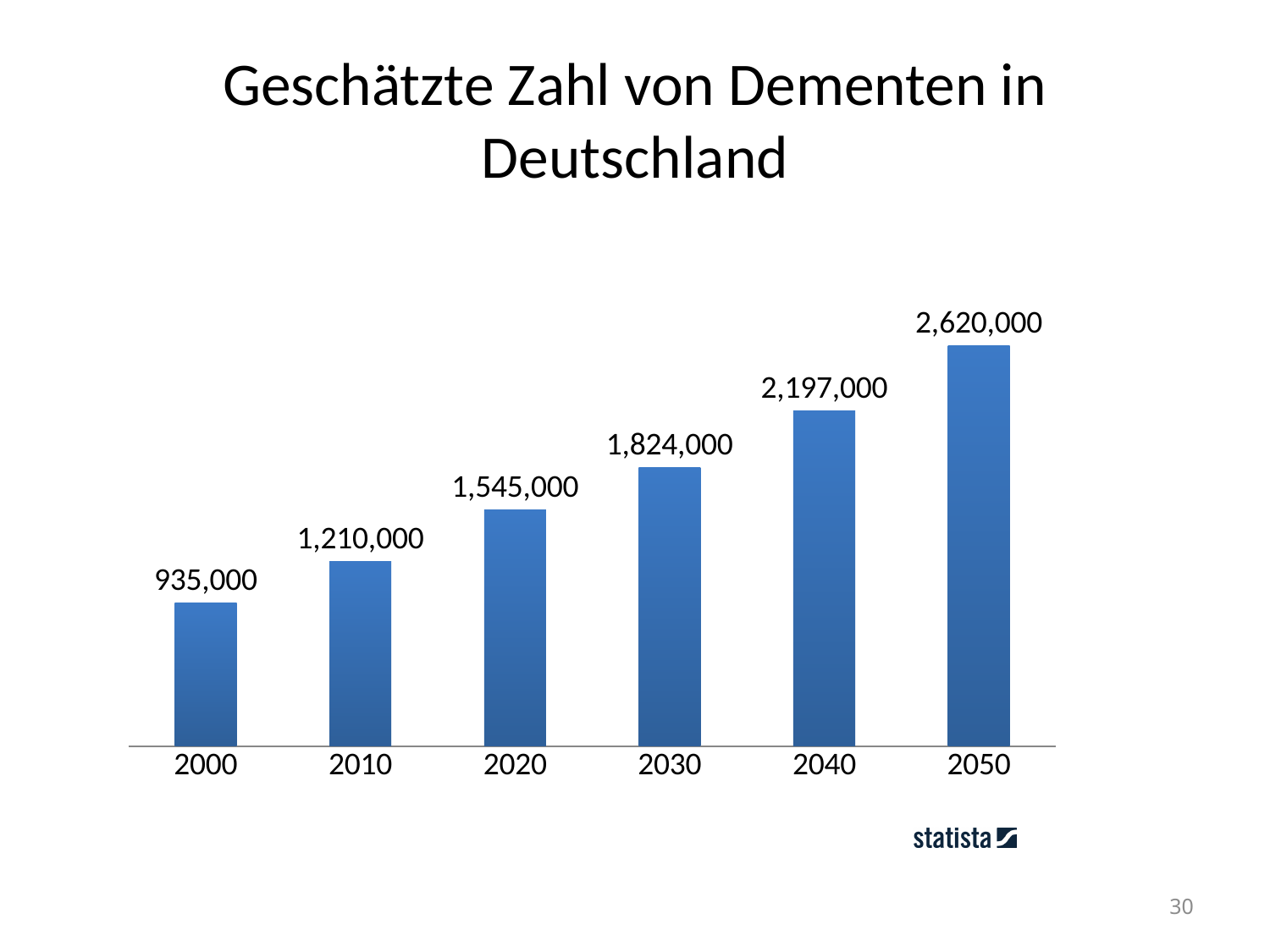
How many years are shown on the x axis? 6 Which is larger, the value for 2040 or the value for 2030? 2040 Which year has the highest value? 2050 What value is shown for 2030? 1,824,000 Do the values rise or fall from 2000 to 2050? rise What is the estimated number of people with dementia in Germany in 2000? 935,000 What is the difference between the values for 2020 and 2010? 335,000 Which year has the lowest value? 2000 What is the difference between the values for 2050 and 2000? 1,685,000 What value is shown for 2050? 2,620,000 What kind of chart is this? bar chart What is the title of the chart? Geschätzte Zahl von Dementen in Deutschland